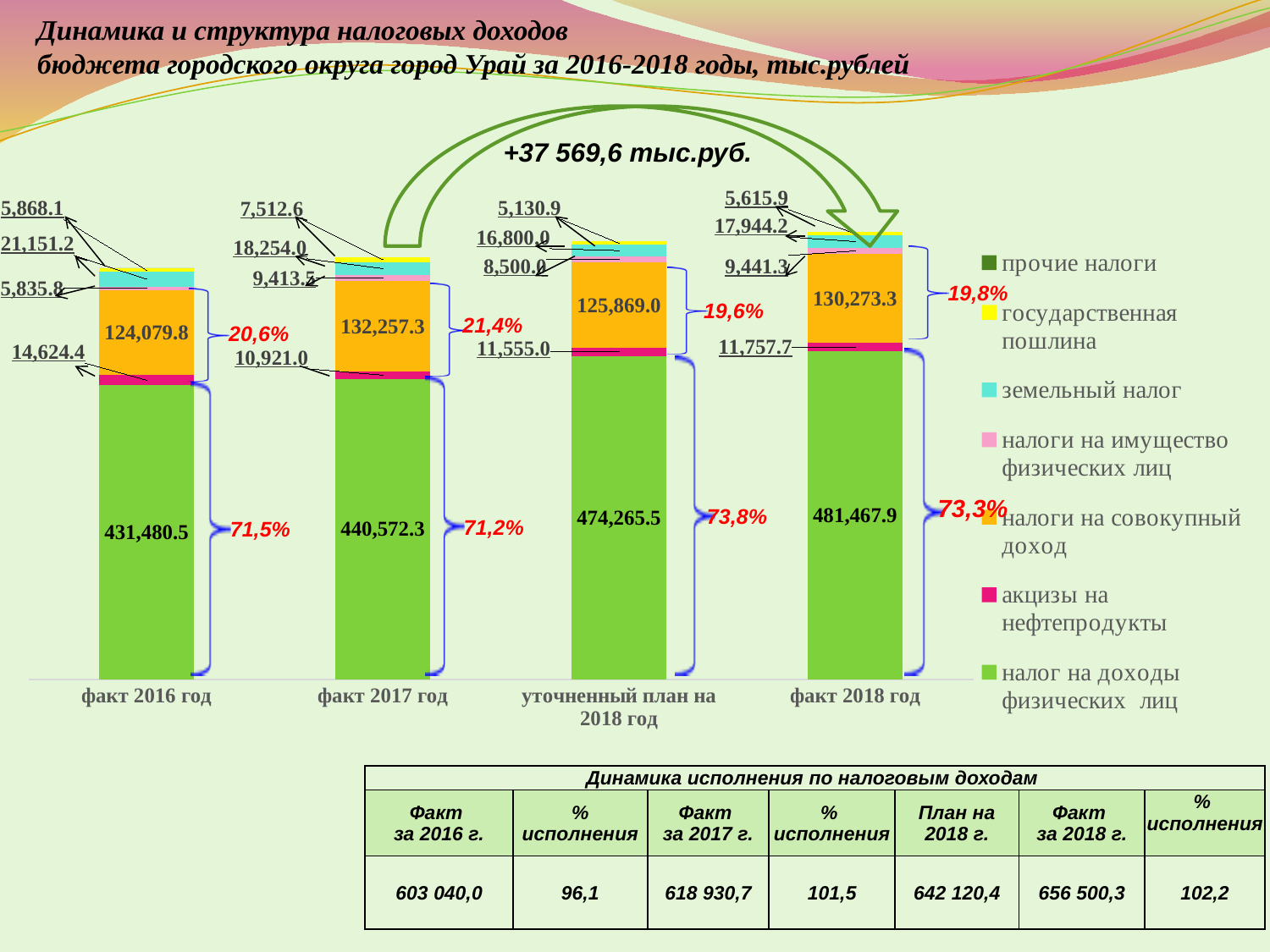
How many categories are shown on the x axis of the chart? 4 How many series does the legend list? 7 Which category has the highest value for налог на доходы физических лиц? факт 2018 год What is the value of налог на доходы физических лиц for факт 2016 год? 431,480.5 Which is larger for налоги на совокупный доход: факт 2017 год or уточненный план на 2018 год? факт 2017 год What is the difference between налог на доходы физических лиц for факт 2018 год and факт 2017 год? 40,895.6 Does the value of налог на доходы физических лиц rise or fall from факт 2016 год to факт 2018 год? rises What is the value of налог на доходы физических лиц for уточненный план на 2018 год? 474,265.5 Which category has the lowest value for акцизы на нефтепродукты? факт 2017 год What is the value of налоги на совокупный доход for факт 2017 год? 132,257.3 What kind of chart is shown on the slide? stacked bar chart What is the value of акцизы на нефтепродукты for факт 2018 год? 11,757.7